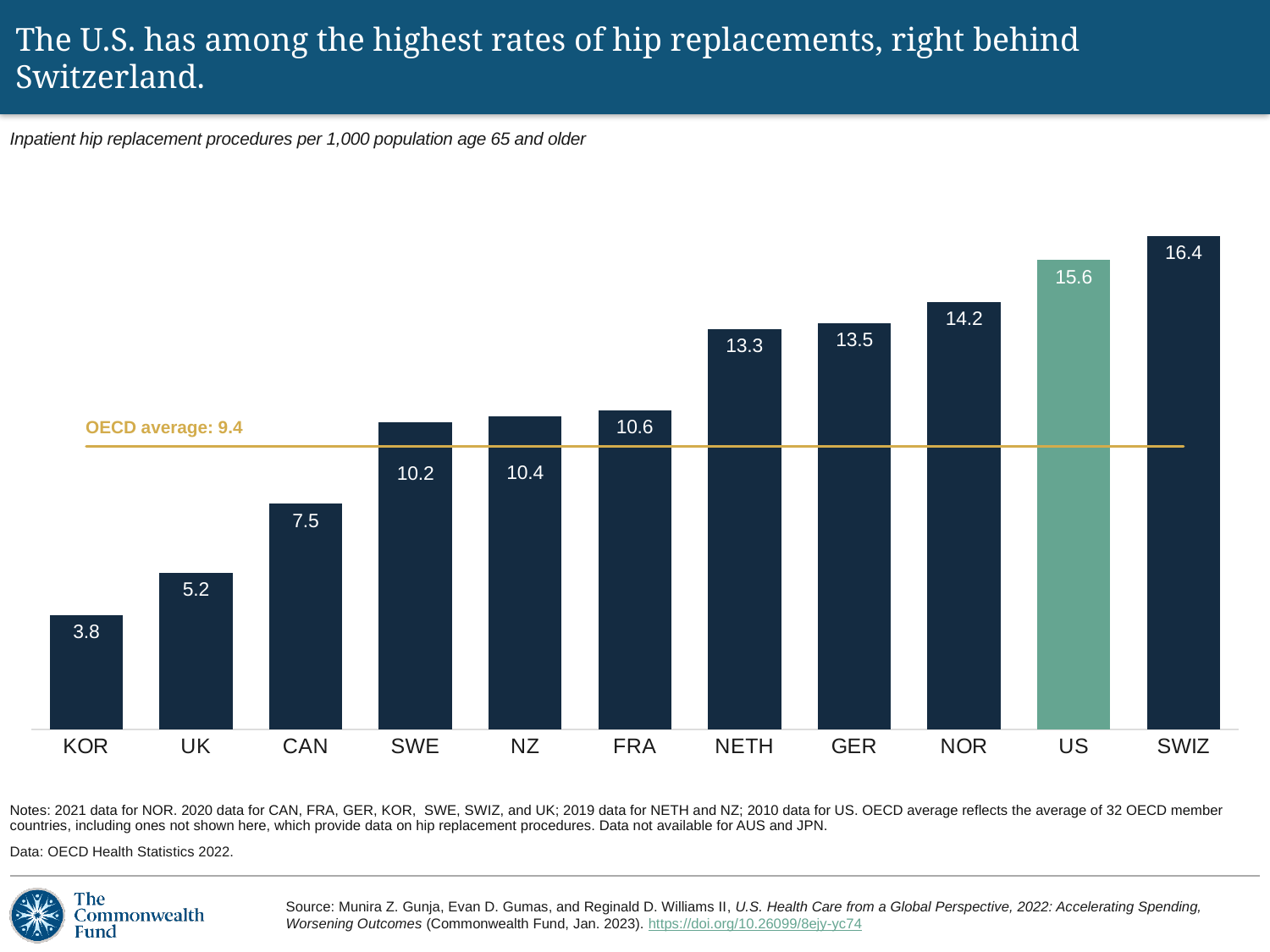
What is the difference between the values for SWIZ and the US? 0.8 Which country has the lowest rate of hip replacements? KOR Which country's bar is shown in a different colour (green) from the others? US Which is larger, the value for NOR or the value for GER? NOR What is the value for the US? 15.6 Which country has the highest rate of hip replacements? SWIZ Do the values rise or fall from left to right across the countries? Rise What is the difference between the values for UK and KOR? 1.4 How many countries are shown in the chart? 11 What kind of chart is shown on the slide? Bar chart What is the value for CAN? 7.5 What is the OECD average shown by the horizontal line? 9.4